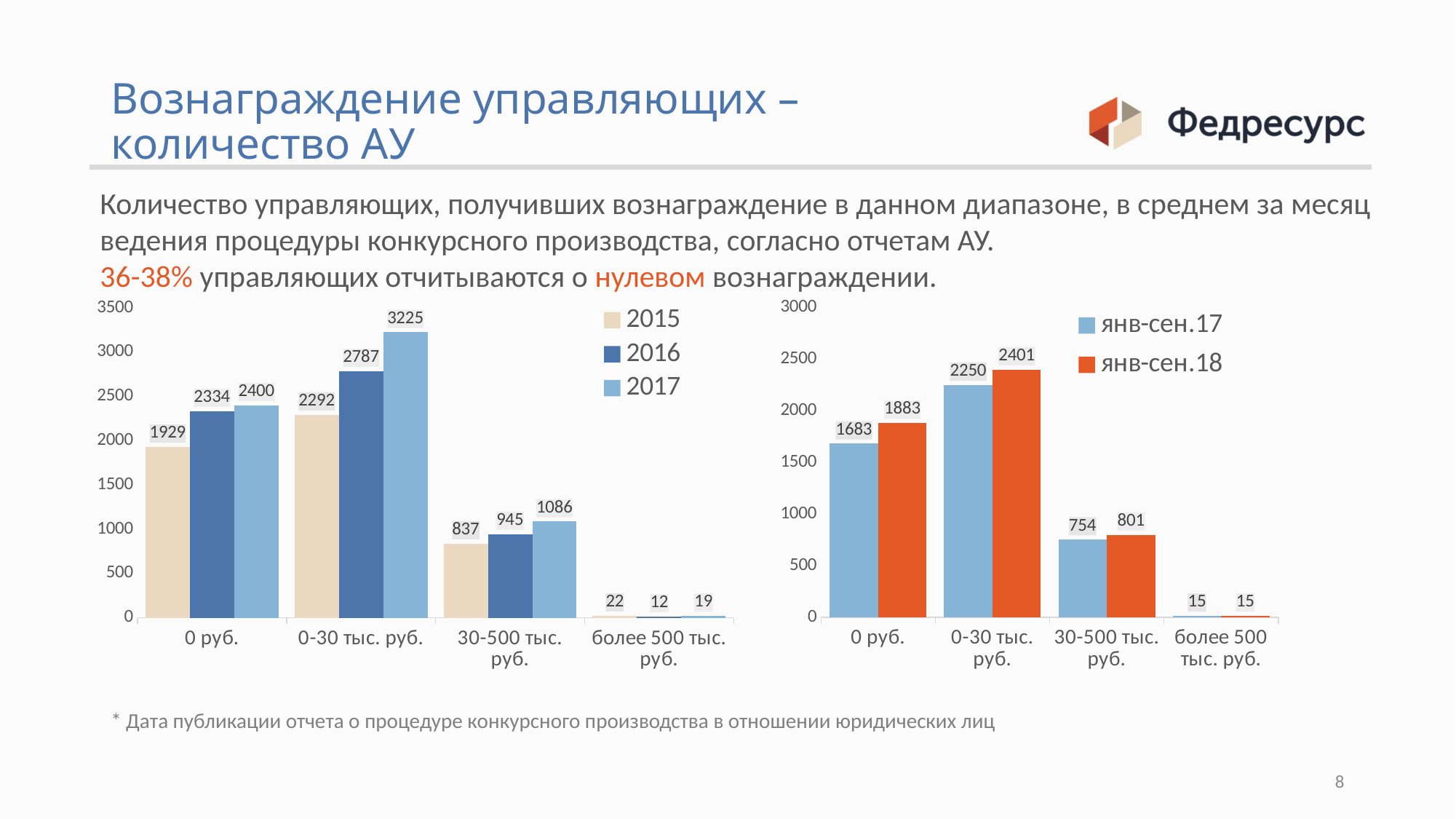
In the left chart, which category has the lowest value for 2016? более 500 тыс. руб. What type of chart is the right chart? Bar chart How many categories are shown on the x axis of the left chart? 4 In the right chart, which category has the highest value for янв-сен.17? 0-30 тыс. руб. In the left chart, what is the value for 2015 in the 0 руб. category? 1929 In the left chart, what is the value for 2017 in the 0-30 тыс. руб. category? 3225 In the left chart, what are the three series listed in the legend? 2015, 2016, 2017 In the right chart, what is the value for янв-сен.18 in the 30-500 тыс. руб. category? 801 In the left chart, which is larger in the 30-500 тыс. руб. category: the 2015 value or the 2017 value? 2017 In the left chart, what is the difference between the 2017 and 2016 values in the 0-30 тыс. руб. category? 438 In the right chart, what is the difference between the янв-сен.18 and янв-сен.17 values in the 0 руб. category? 200 In the right chart, how many series does the legend list? 2